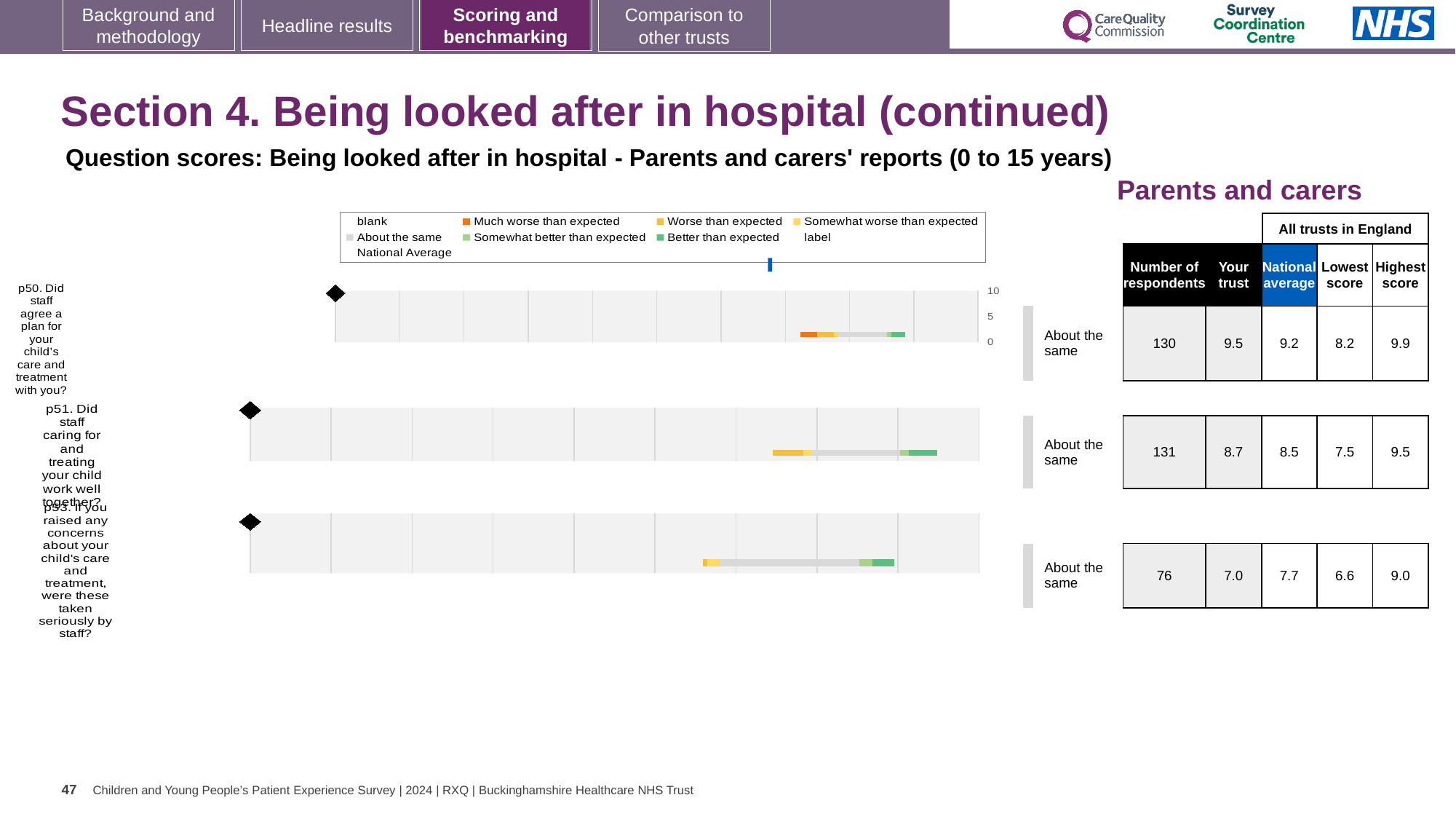
What kind of chart is used to show the question scores on this slide? bar chart For p50 (Did staff agree a plan for your child's care and treatment with you?), what is the 'Your trust' score? 9.5 How many survey questions (p50, p51, p53) are plotted on the slide? 3 What benchmark category is shown for p51? About the same For p50, what is the difference between the highest score and the lowest score across all trusts in England? 1.7 Which question has the highest 'Your trust' score? p50 For p53 (If you raised any concerns about your child's care and treatment, were these taken seriously by staff?), how many respondents were there? 76 Is the 'Your trust' score for p50 greater or less than 5 on the chart axis? greater For p51, what is the lowest score among all trusts in England? 7.5 For p53, which is larger: the 'Your trust' score or the national average? National average For p51 (Did staff caring for and treating your child work well together?), what is the national average score? 8.5 Which question has the lowest 'Your trust' score? p53